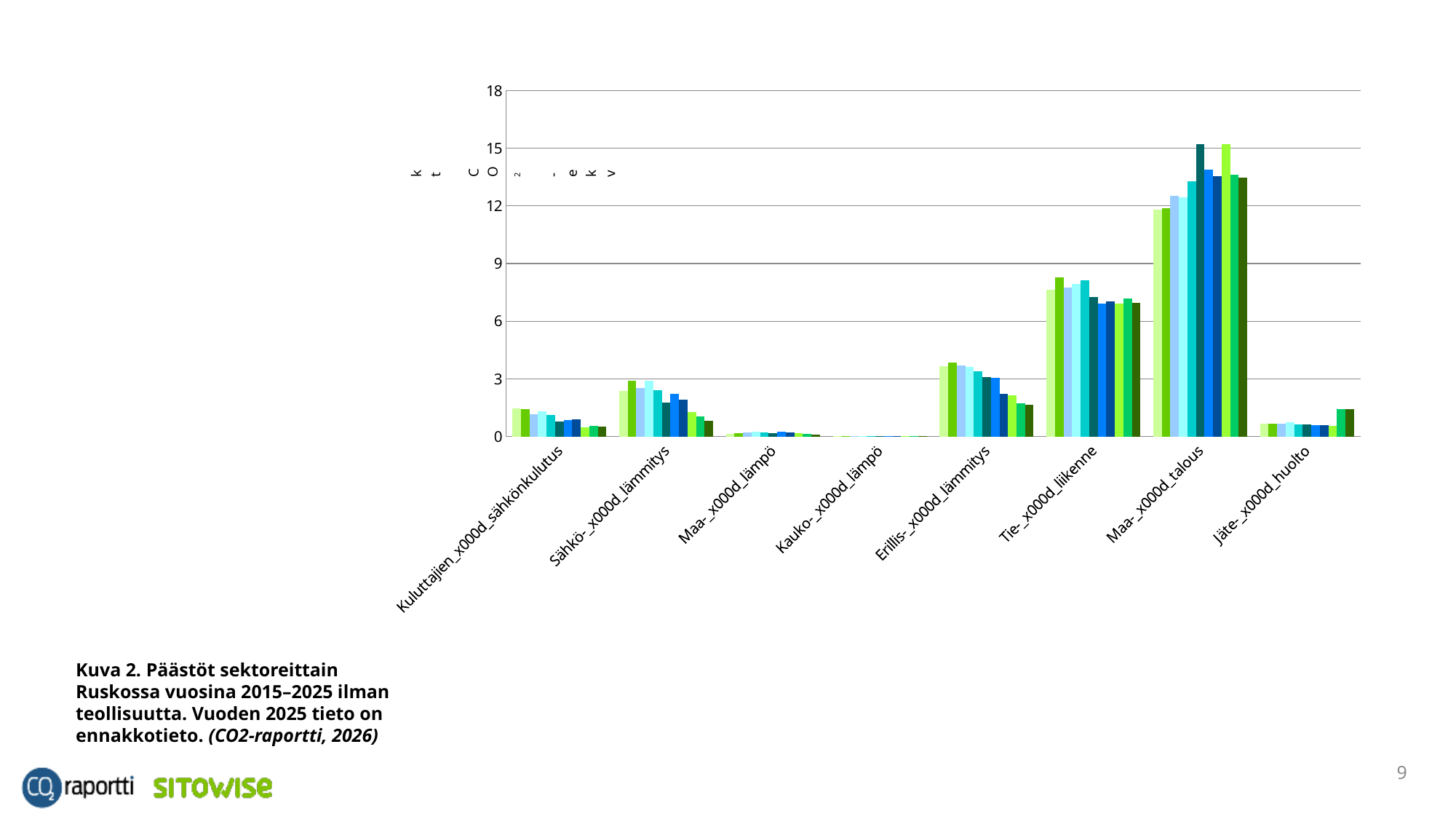
Are the bars for Maa-talous greater or less than 9? greater Are the bars for Kuluttajien sähkönkulutus greater or less than 3? less What kind of chart is shown on the slide? Bar chart Within the Erillis-lämmitys group, do the bars rise or fall from left to right? fall Which sector has higher bars, Tie-liikenne or Erillis-lämmitys? Tie-liikenne What is the highest value shown on the y axis? 18 Which sector has the tallest bars in the chart? Maa-talous Which sector has the lowest bars in the chart? Kauko-lämpö How many sector categories are shown along the x axis? 8 Are the bars for Erillis-lämmitys greater or less than 6? less According to the caption, which municipality and years does the chart cover? Rusko, 2015–2025